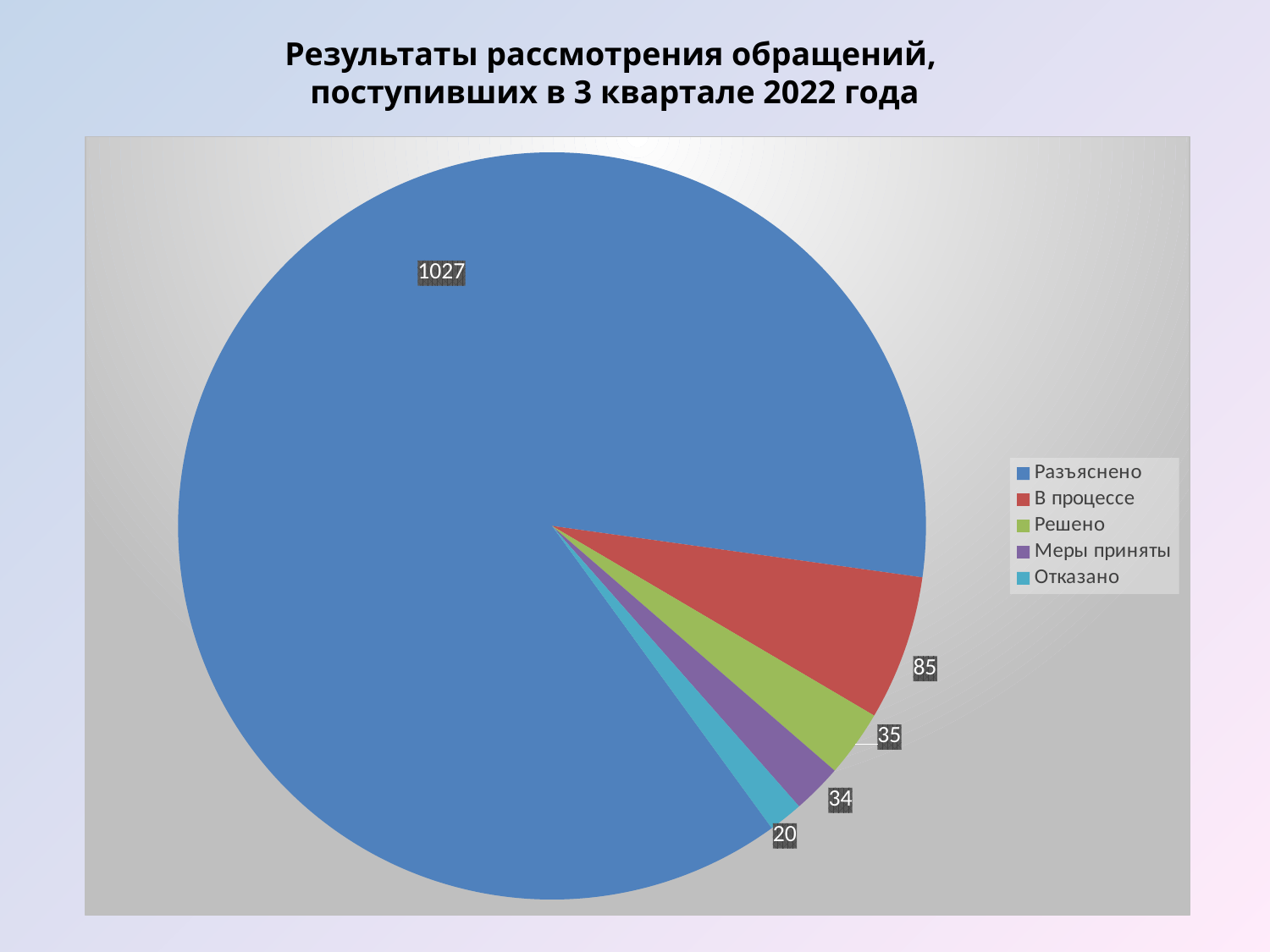
What is the difference between the values for В процессе and Отказано? 65 Which category has the smallest slice? Отказано What is the value for Отказано? 20 What is the value for Разъяснено? 1027 What is the total of all slices in the pie? 1201 What is the value for В процессе? 85 What kind of chart is shown on the slide? pie chart Which is larger, the value for В процессе or the value for Меры приняты? В процессе What is the value for Решено? 35 How many categories does the legend list? 5 What is the title of the chart? Результаты рассмотрения обращений, поступивших в 3 квартале 2022 года Which category has the largest slice? Разъяснено